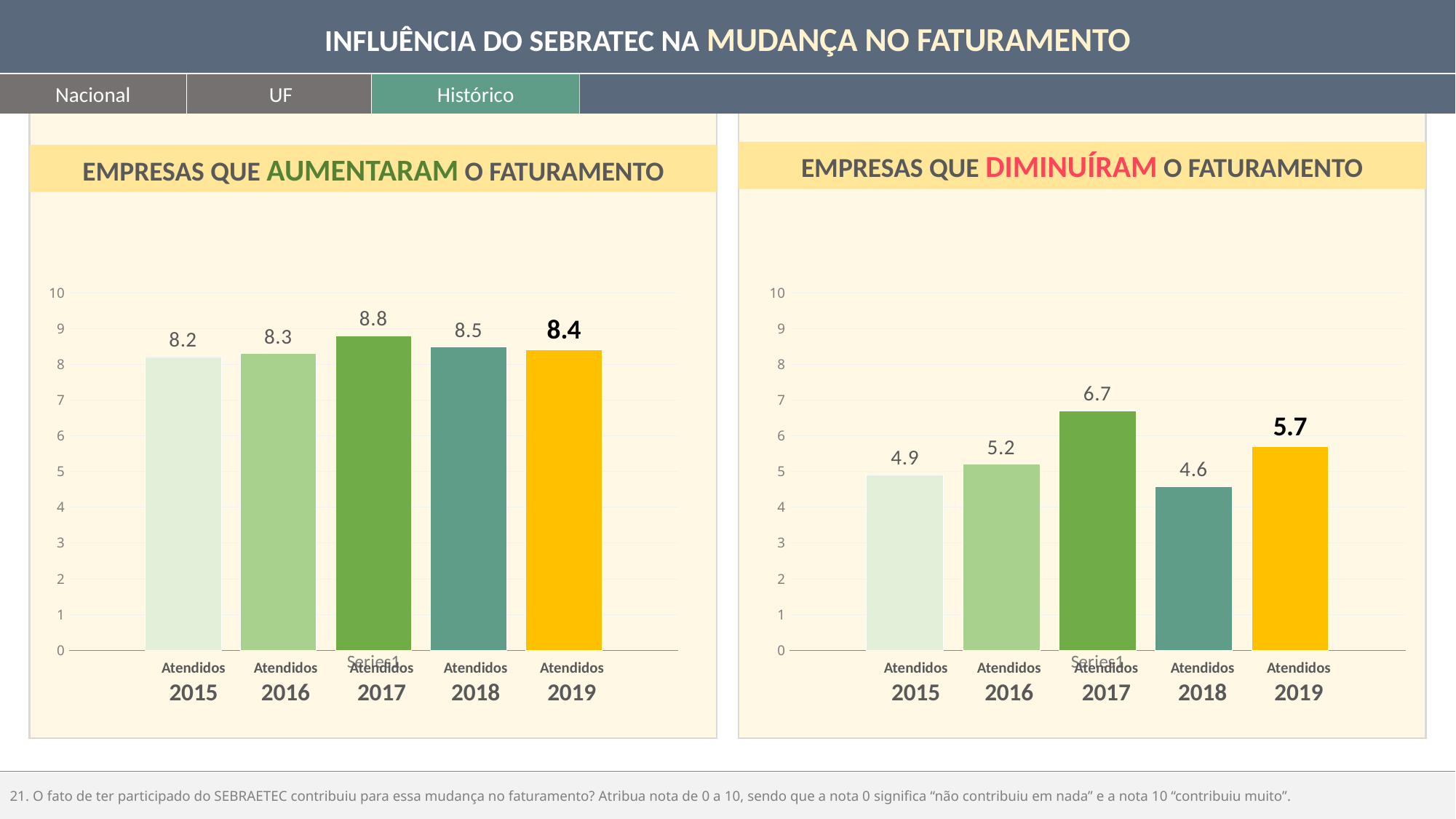
In the 'Empresas que diminuíram o faturamento' chart, which is larger, the value for 2015 or the value for 2019? 2019 In the 'Empresas que diminuíram o faturamento' chart, what is the difference between the 2017 and 2018 values? 2.1 In the 'Empresas que diminuíram o faturamento' chart, which year has the lowest value? 2018 In the 'Empresas que aumentaram o faturamento' chart, which year has the highest value? 2017 In the 'Empresas que aumentaram o faturamento' chart, what is the value for 2019? 8.4 In the 'Empresas que aumentaram o faturamento' chart, which year has the lowest value? 2015 In the 'Empresas que aumentaram o faturamento' chart, what is the value for 2017? 8.8 In the 'Empresas que diminuíram o faturamento' chart, what is the value for 2019? 5.7 What kind of chart is the 'Empresas que aumentaram o faturamento' chart? Bar chart In the 'Empresas que diminuíram o faturamento' chart, what is the value for 2016? 5.2 In the 'Empresas que aumentaram o faturamento' chart, what is the difference between the 2017 and 2015 values? 0.6 In the 'Empresas que diminuíram o faturamento' chart, which year has the highest value? 2017